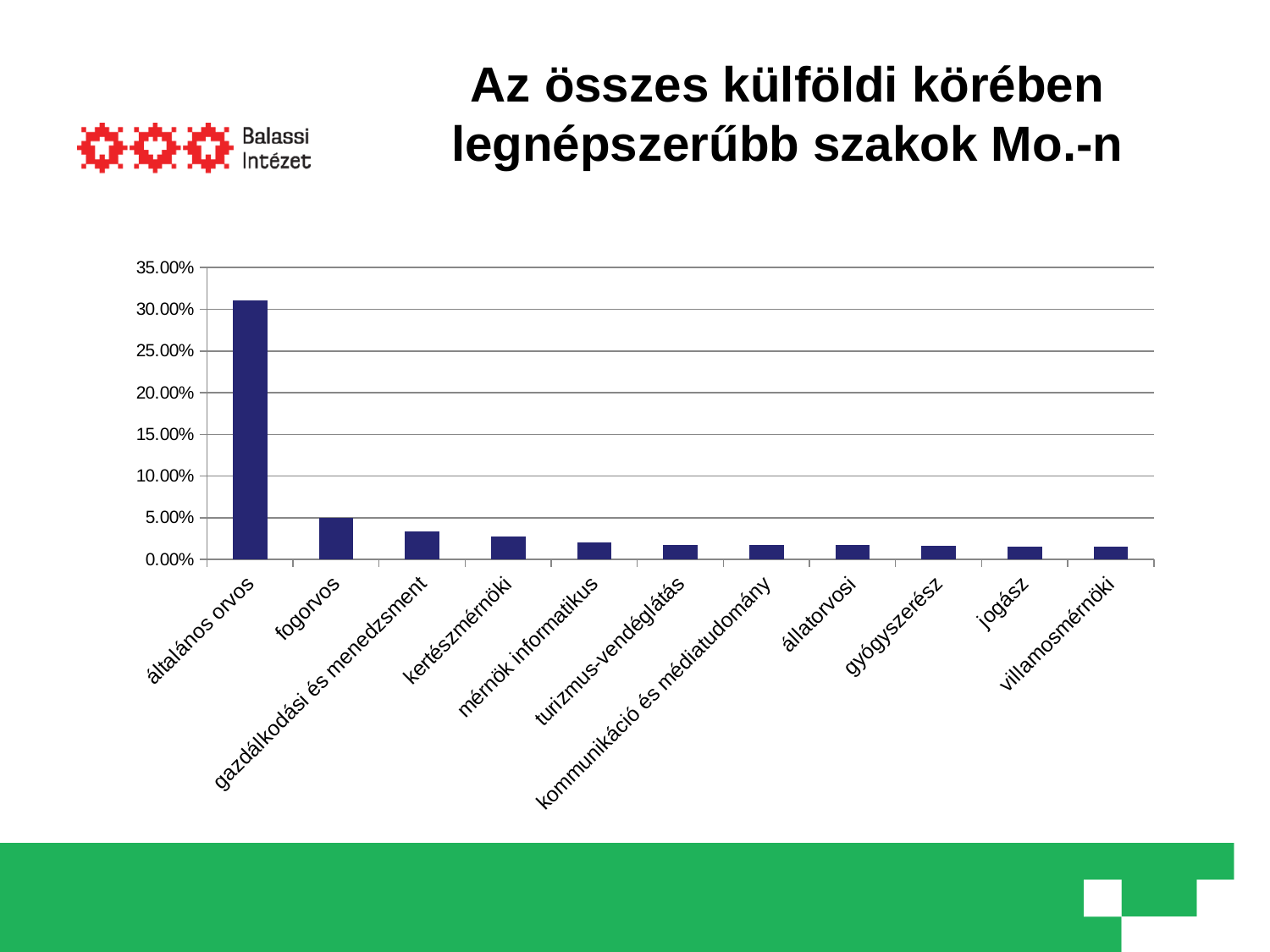
Is the value for jogász greater or less than 5.00%? less Which category has the highest value in the chart? általános orvos Which is larger, the value for általános orvos or the value for fogorvos? általános orvos Which is larger, the value for gazdálkodási és menedzsment or the value for mérnök informatikus? gazdálkodási és menedzsment How many categories (szakok) are shown on the x axis of the chart? 11 Do the values generally rise or fall moving from left to right along the x axis? fall What is the title of the chart on the slide? Az összes külföldi körében legnépszerűbb szakok Mo.-n Is the value for gazdálkodási és menedzsment greater or less than 5.00%? less What kind of chart is shown on the slide? bar chart Which is larger, the value for fogorvos or the value for kertészmérnöki? fogorvos Is the value for fogorvos greater or less than 10.00%? less